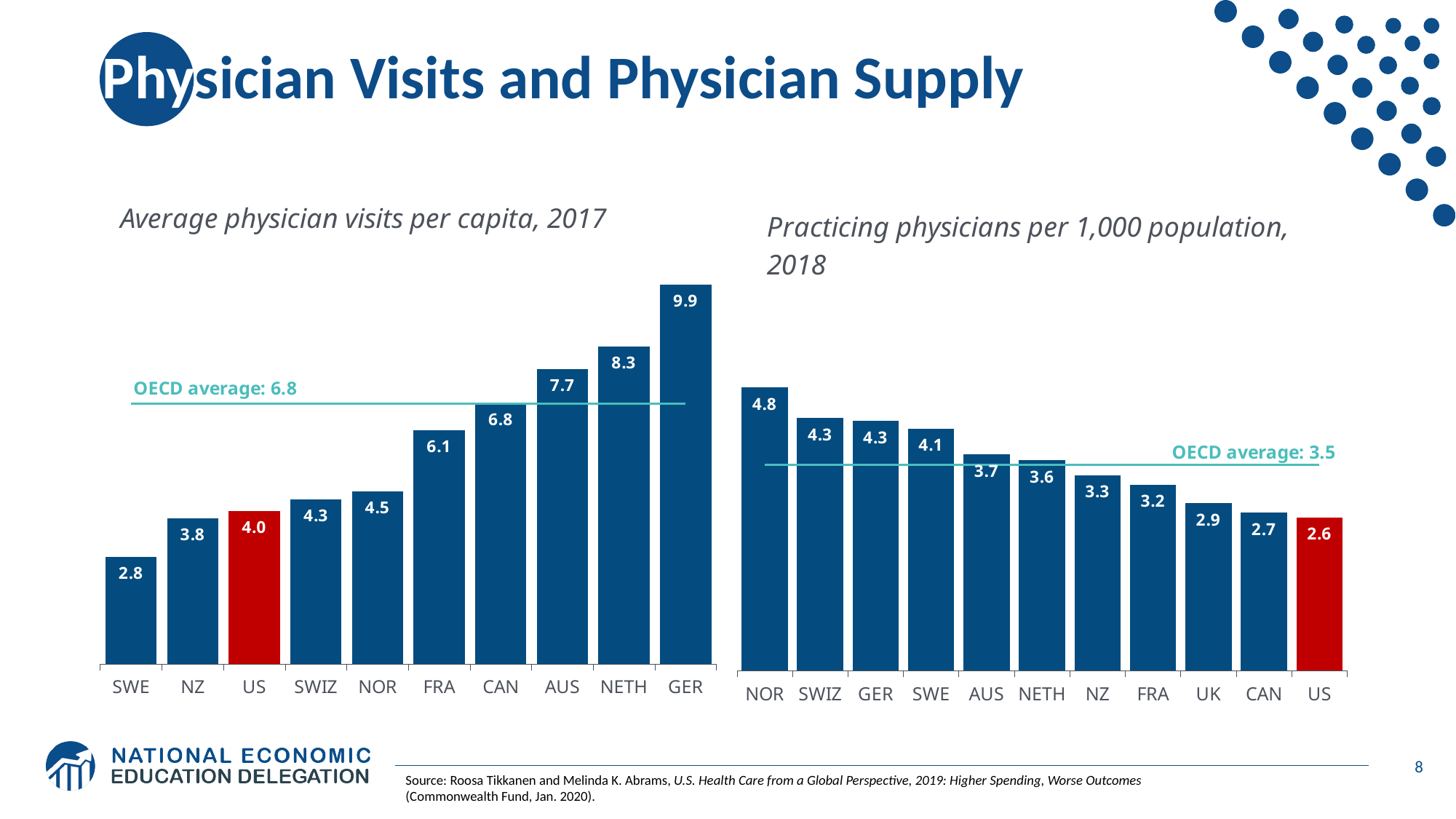
In the 'Average physician visits per capita, 2017' chart, which country has the lowest value? SWE In the 'Practicing physicians per 1,000 population, 2018' chart, how many countries are shown? 11 In the 'Practicing physicians per 1,000 population, 2018' chart, which country has the lowest value? US What kind of chart is the 'Average physician visits per capita, 2017' chart? Bar chart In the 'Average physician visits per capita, 2017' chart, what is the difference between GER and SWE? 7.1 In the 'Practicing physicians per 1,000 population, 2018' chart, which is larger, the value for NETH or the value for UK? NETH In the 'Average physician visits per capita, 2017' chart, what is the value for the US? 4.0 In the 'Average physician visits per capita, 2017' chart, how many countries are shown? 10 In the 'Practicing physicians per 1,000 population, 2018' chart, what is the difference between NOR and US? 2.2 In the 'Average physician visits per capita, 2017' chart, which country has the highest value? GER In the 'Practicing physicians per 1,000 population, 2018' chart, what is the value for NOR? 4.8 In the 'Practicing physicians per 1,000 population, 2018' chart, what OECD average is shown by the horizontal line? 3.5